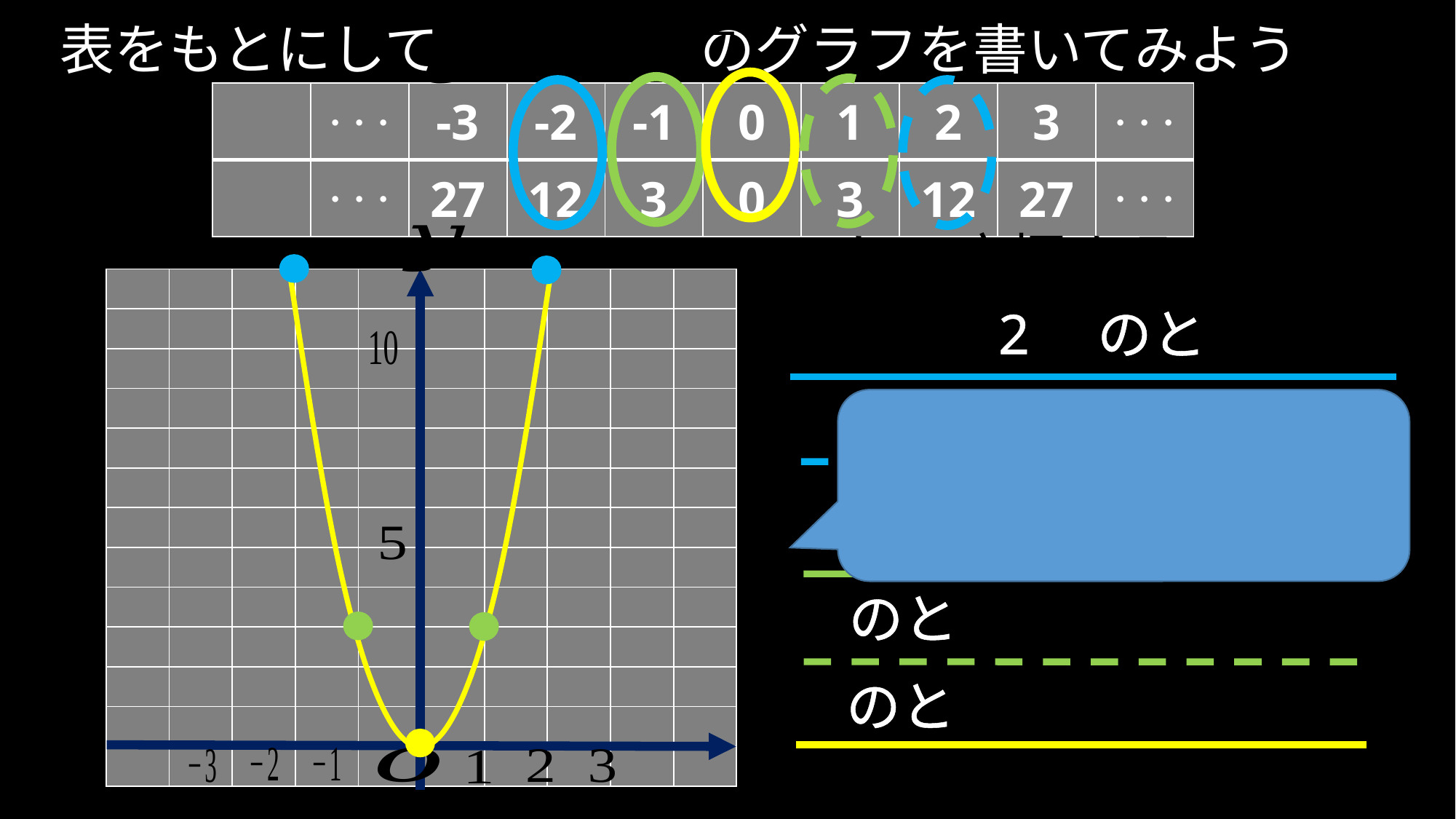
On the graph, do the y values rise or fall as x increases from 0 to 3? rise According to the table, what is the y value when x = 0? 0 On the graph, is the plotted point at x = 1 greater or less than 5 on the y axis? less On the graph, is the plotted point at x = 2 greater or less than 10 on the y axis? greater Which has the larger y value in the table, x = -1 or x = 2? x = 2 What colour is the curve drawn on the graph? yellow What is the difference between the y values at x = 3 and x = 2 in the table? 15 At which x value in the table is the y value lowest? 0 According to the table, what is the y value when x = -2? 12 How many x values (excluding the '...' cells) are listed in the table? 7 How many points are marked with coloured dots on the graph? 5 According to the table, what is the y value when x = 3? 27